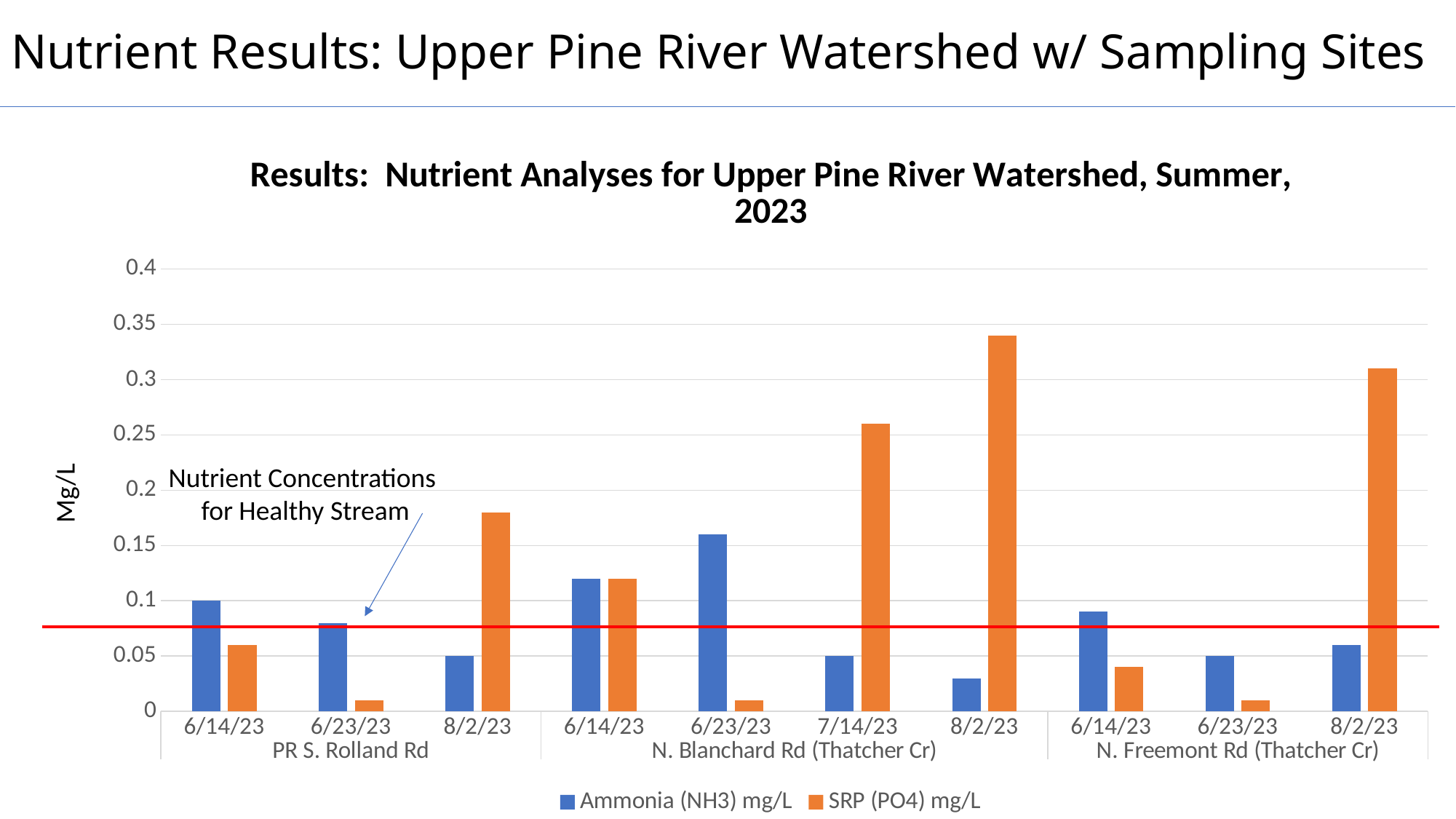
Is the SRP (PO4) mg/L value for N. Blanchard Rd (Thatcher Cr) on 8/2/23 greater or less than 0.3? greater How many sampling sites are shown along the x axis? 3 Is the SRP (PO4) mg/L value for N. Blanchard Rd (Thatcher Cr) on 7/14/23 greater or less than 0.2? greater What does the red horizontal line on the chart represent? Nutrient Concentrations for Healthy Stream How many series does the legend list? 2 Which sampling site and date has the highest Ammonia (NH3) mg/L value? N. Blanchard Rd (Thatcher Cr), 6/23/23 How many sampling dates are shown along the x axis in total? 10 Which is larger at PR S. Rolland Rd on 6/14/23: Ammonia (NH3) mg/L or SRP (PO4) mg/L? Ammonia (NH3) mg/L Which is larger on 8/2/23: the SRP (PO4) mg/L value at N. Blanchard Rd (Thatcher Cr) or at N. Freemont Rd (Thatcher Cr)? N. Blanchard Rd (Thatcher Cr) Is the SRP (PO4) mg/L value for PR S. Rolland Rd on 8/2/23 greater or less than 0.15? greater Which sampling site and date has the highest SRP (PO4) mg/L value? N. Blanchard Rd (Thatcher Cr), 8/2/23 What type of chart is shown on the slide? bar chart